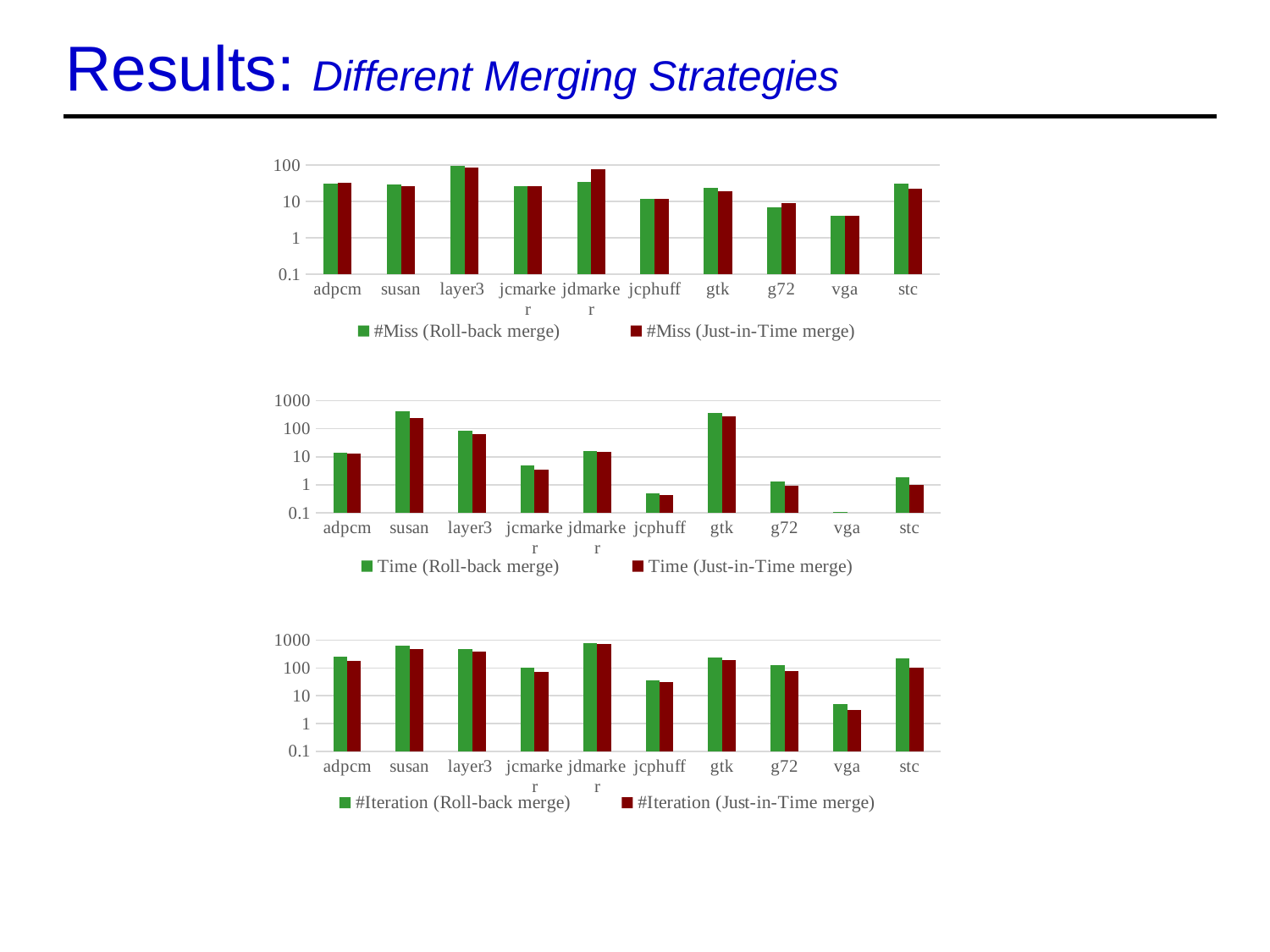
What kind of chart is the top chart on the slide (the #Miss chart)? bar chart In the bottom chart (#Iteration), is the value for adpcm under #Iteration (Roll-back merge) greater or less than 100? greater In the top chart (#Miss), which category has the highest value for #Miss (Roll-back merge)? layer3 How many series does the legend of the middle chart (Time) list? 2 In the bottom chart (#Iteration), which category has the lowest value for #Iteration (Roll-back merge)? vga In the top chart (#Miss), is the value for vga under #Miss (Just-in-Time merge) greater or less than 10? less In the middle chart (Time), which is larger for Time (Roll-back merge): susan or layer3? susan In the middle chart (Time), is the value for susan under Time (Roll-back merge) greater or less than 100? greater What is the second legend entry of the bottom chart? #Iteration (Just-in-Time merge) How many categories are shown on the x axis of the top chart (#Miss)? 10 In the top chart (#Miss), which category has the lowest value for #Miss (Roll-back merge)? vga